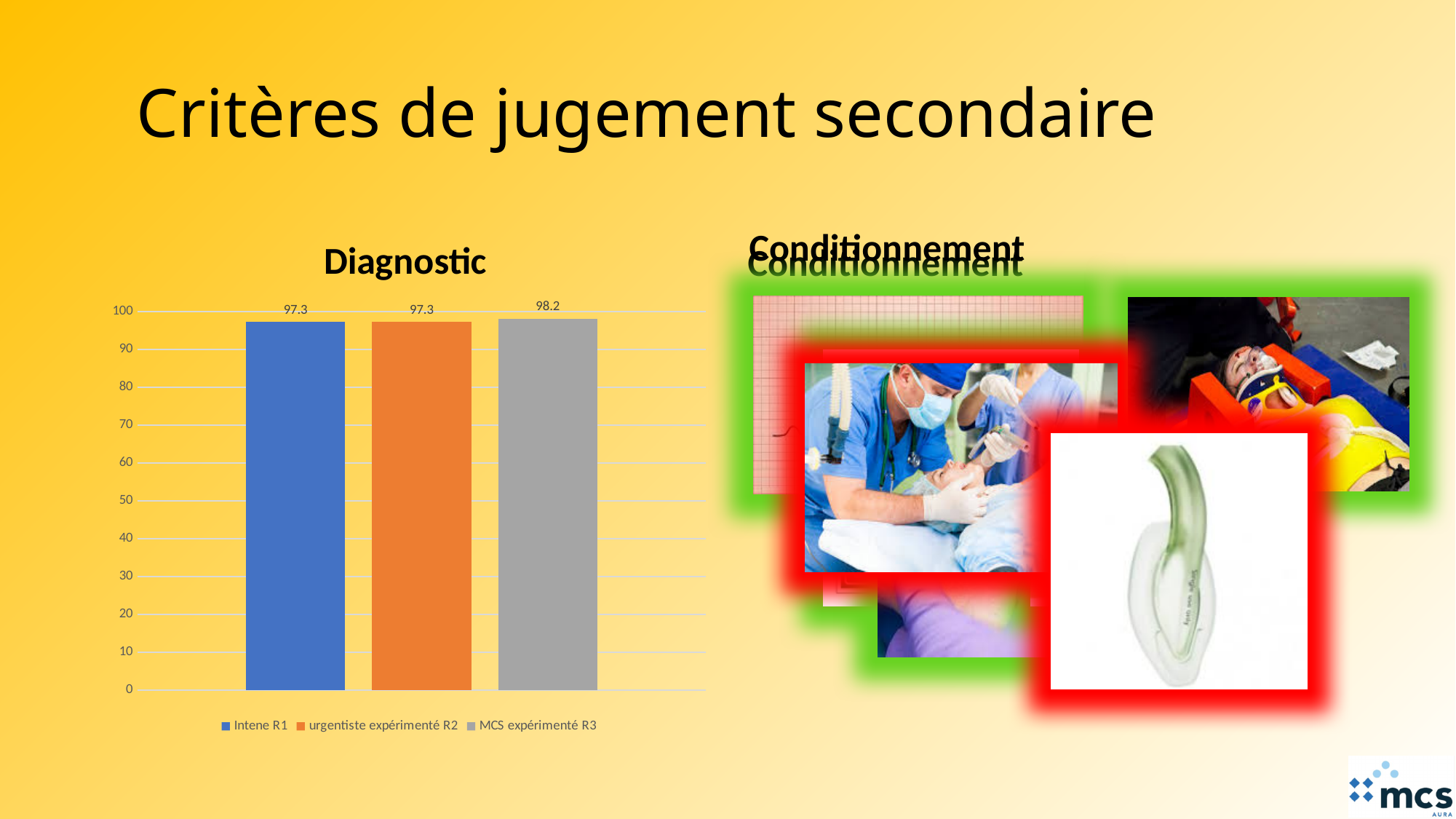
What is the title of the chart on the slide? Diagnostic What is the value for Intene R1 in the Diagnostic chart? 97.3 What is the value for MCS expérimenté R3 in the Diagnostic chart? 98.2 Which is larger in the Diagnostic chart, the value for Intene R1 or the value for MCS expérimenté R3? MCS expérimenté R3 How many bars are plotted in the Diagnostic chart? 3 How many series does the legend of the Diagnostic chart list? 3 Which series has the highest value in the Diagnostic chart? MCS expérimenté R3 Is the value for urgentiste expérimenté R2 in the Diagnostic chart greater or less than 90? greater What colour is the bar for Intene R1 in the Diagnostic chart? blue What is the value for urgentiste expérimenté R2 in the Diagnostic chart? 97.3 What is the difference between the values for MCS expérimenté R3 and Intene R1 in the Diagnostic chart? 0.9 What kind of chart is shown on the slide? bar chart